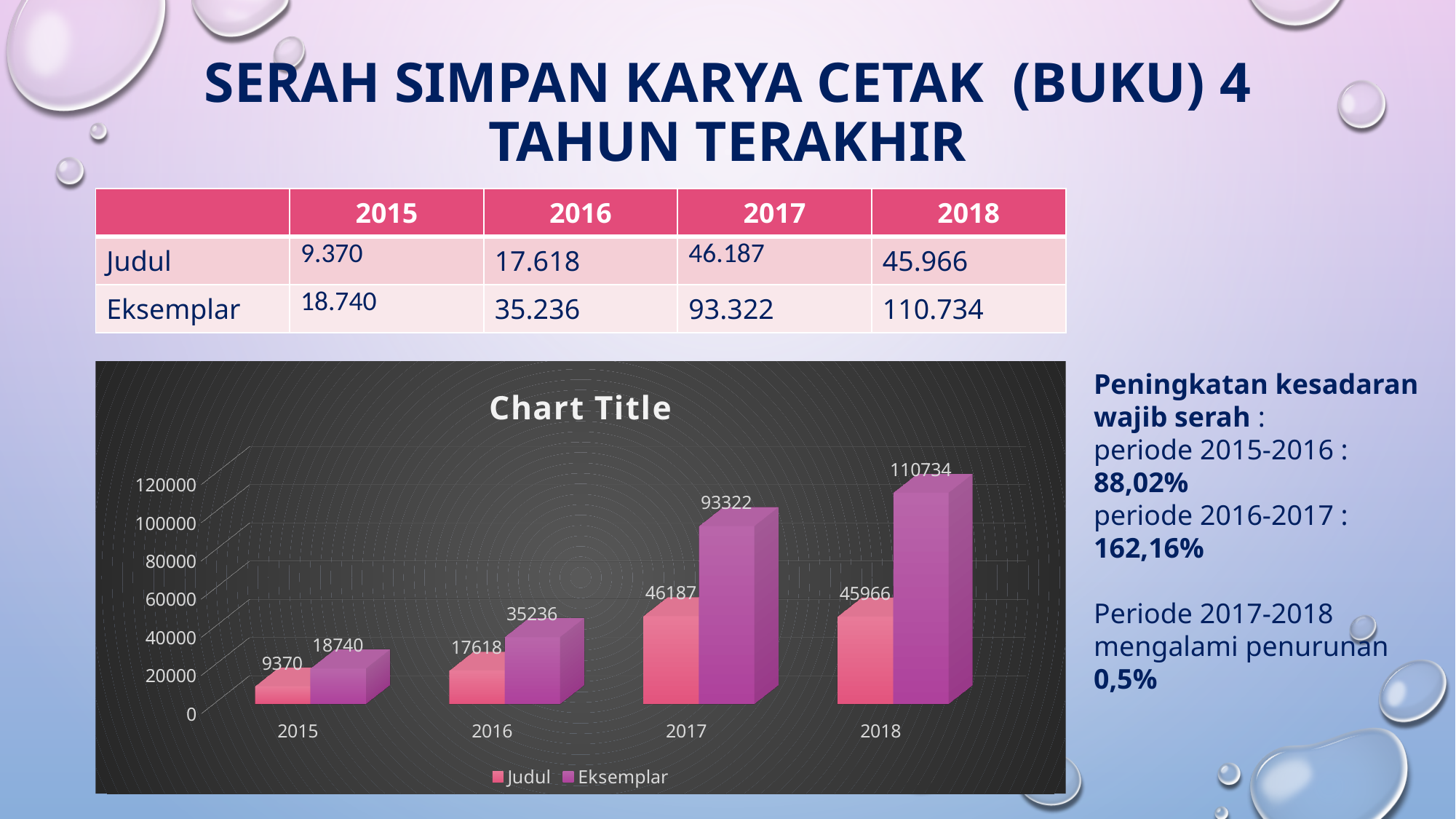
Does the Eksemplar value rise or fall from 2015 to 2018 in the chart? rise What is the difference between the Eksemplar values for 2018 and 2017? 17412 Which is larger, the Judul value for 2017 or the Judul value for 2018? 2017 What is the Judul value for 2016 in the chart? 17618 Which year has the lowest Judul value in the chart? 2015 Which year has the highest Eksemplar value in the chart? 2018 How many years are shown on the x axis of the chart? 4 How many series does the chart legend list? 2 What is the Eksemplar value for 2017 in the chart? 93322 What is the title shown on the chart? Chart Title What is the difference between the Eksemplar and Judul values for 2015? 9370 What type of chart is shown on the slide? bar chart